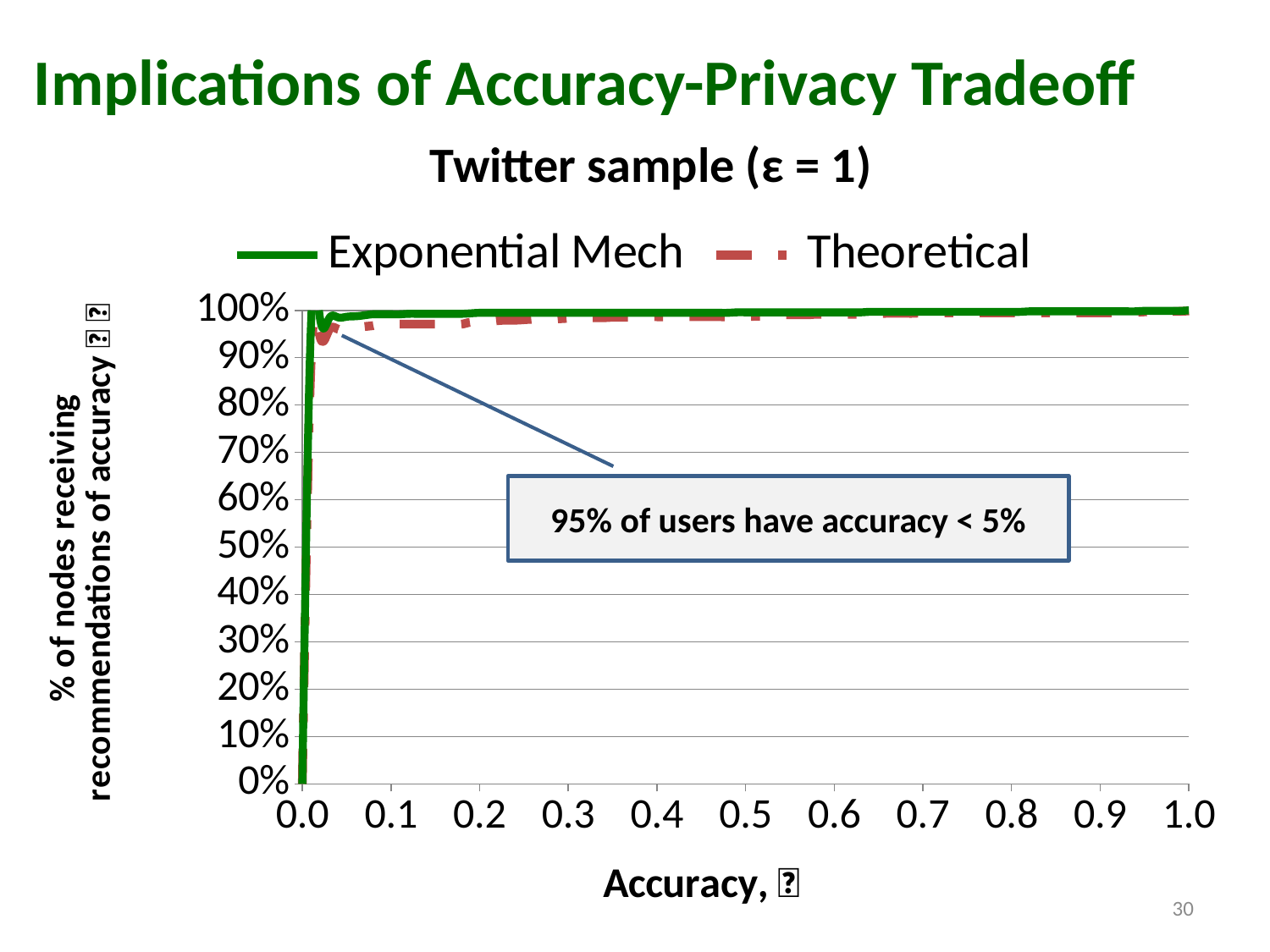
What kind of chart is shown on the slide? line chart Which series is drawn as a dashed line in the chart? Theoretical Do the plotted values rise or fall as accuracy increases from 0.0 to 0.1? rise What is the title of the chart? Twitter sample (ε = 1) According to the callout on the chart, what share of users have accuracy below 5%? 95% Is the Exponential Mech value at accuracy 0.5 greater or less than 90%? greater What is the largest accuracy value shown on the x axis? 1.0 Is the Theoretical value at accuracy 0.8 greater or less than 50%? greater How many series does the chart's legend list? 2